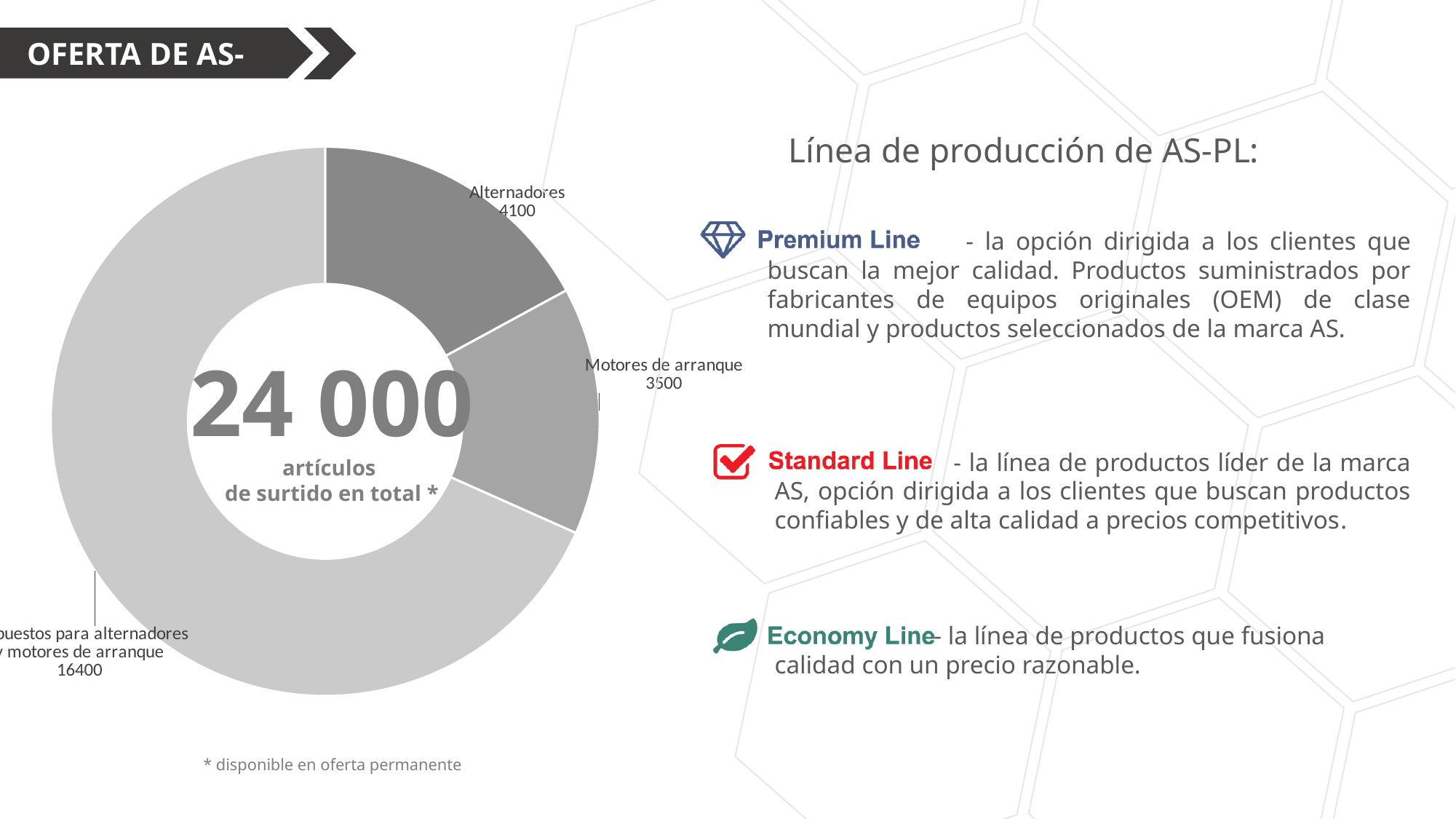
Which category has the smallest value in the doughnut chart? Motores de arranque How many categories (slices) does the doughnut chart have? 3 What does the footnote below the doughnut chart say? * disponible en oferta permanente What is the value shown for the largest slice of the doughnut chart (spare parts for alternators and starter motors)? 16400 What total number is printed in the centre of the doughnut chart? 24 000 What kind of chart is shown on the left of the slide? Doughnut (pie) chart How much larger is the largest slice (16400) than the Alternadores slice? 12300 What is the value shown for Motores de arranque in the doughnut chart? 3500 Which is larger in the doughnut chart, Alternadores or Motores de arranque? Alternadores What text accompanies the number in the centre of the doughnut chart? artículos de surtido en total * What is the difference between the values for Alternadores and Motores de arranque? 600 What is the value shown for Alternadores in the doughnut chart? 4100